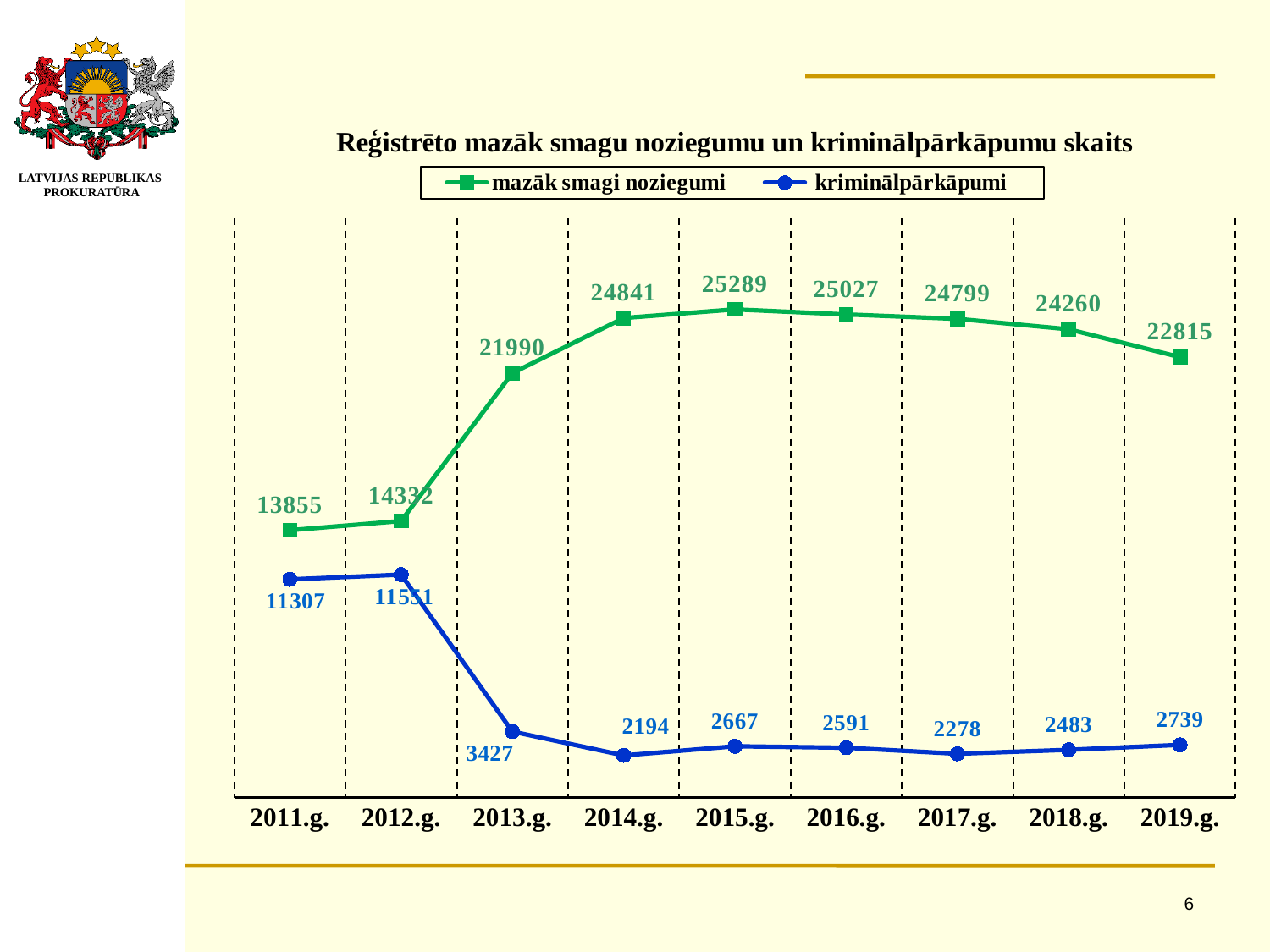
How many years are shown on the x axis? 9 What is the value for mazāk smagi noziegumi in 2015.g.? 25289 Which is larger, the kriminālpārkāpumi value for 2015.g. or for 2017.g.? 2015.g. What is the value for kriminālpārkāpumi in 2013.g.? 3427 Does the kriminālpārkāpumi series rise or fall between 2012.g. and 2014.g.? fall In which year is the value for kriminālpārkāpumi lowest? 2014.g. What is the title of the chart? Reģistrēto mazāk smagu noziegumu un kriminālpārkāpumu skaits In which year is the value for mazāk smagi noziegumi highest? 2015.g. What is the value for mazāk smagi noziegumi in 2019.g.? 22815 What type of chart is shown on the slide? line chart What is the difference between the mazāk smagi noziegumi values for 2014.g. and 2013.g.? 2851 How many series does the legend list? 2